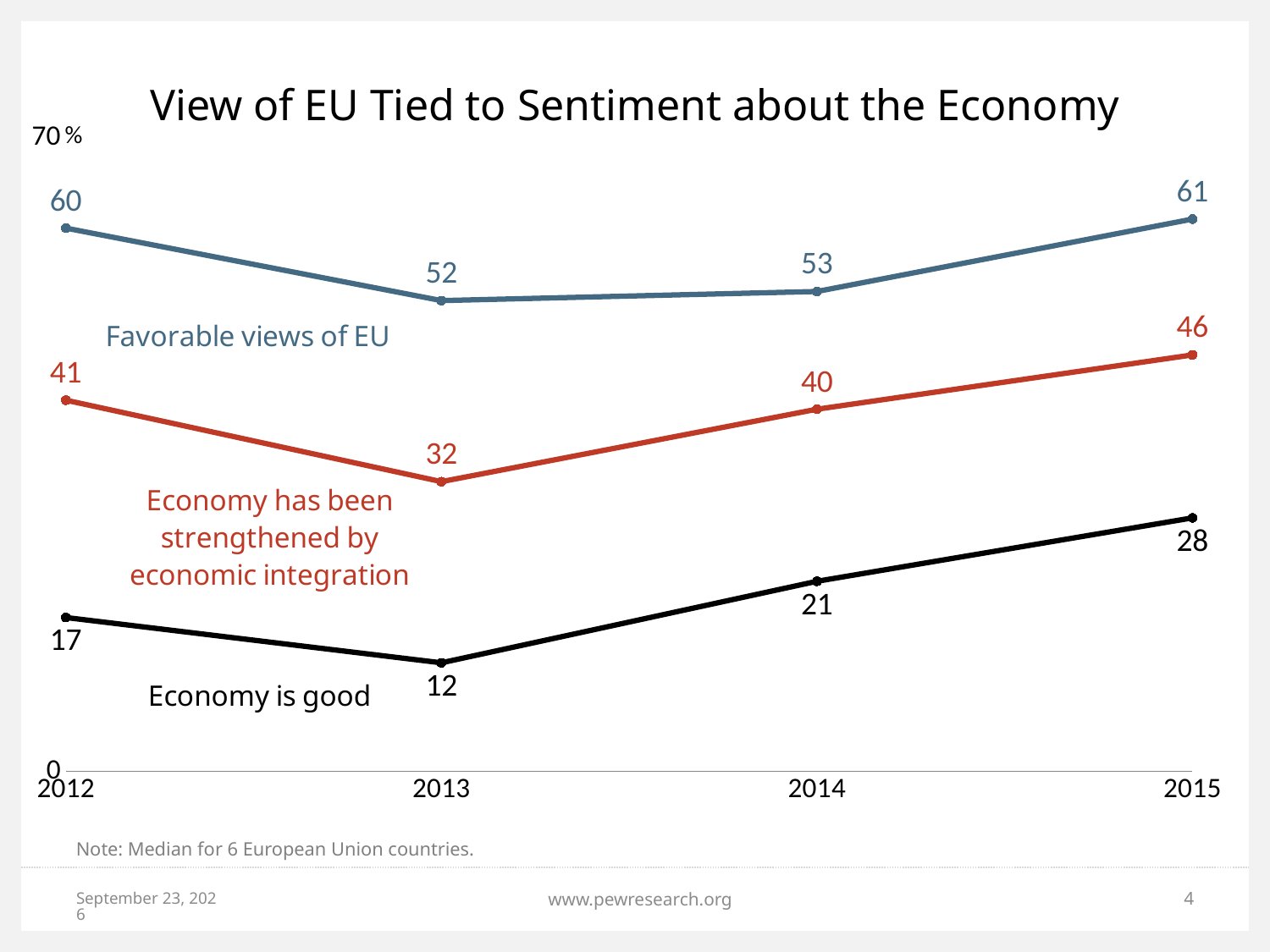
Which is larger in 2014: Favorable views of EU or Economy has been strengthened by economic integration? Favorable views of EU Do the values for Economy is good rise or fall from 2013 to 2015? Rise In which year is Favorable views of EU lowest? 2013 What kind of chart is shown on the slide? Line chart What is the difference between Favorable views of EU and Economy is good in 2012? 43 What is the value for Economy has been strengthened by economic integration in 2014? 40 How many years are shown on the x axis? 4 What is the value for Economy is good in 2013? 12 What is the value for Favorable views of EU in 2015? 61 By how much did Economy has been strengthened by economic integration change from 2013 to 2015? 14 In which year is Economy is good highest? 2015 How many series are plotted on the chart? 3